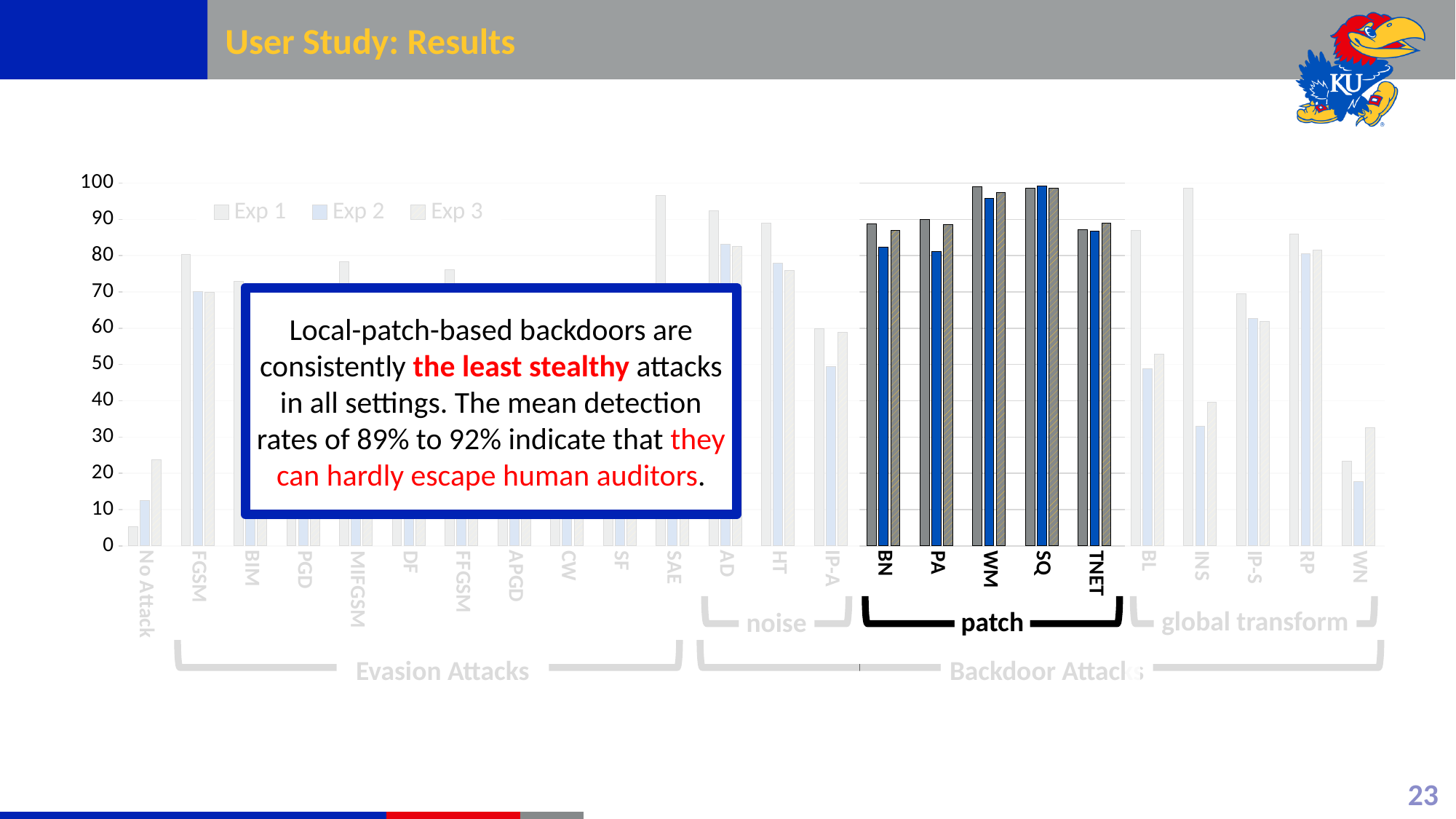
Is the Exp 1 value for No Attack greater or less than 10? less Which is larger, the Exp 1 value for WM or the Exp 2 value for BL? Exp 1 value for WM Which category has the lowest Exp 1 value in the chart? No Attack How many series does the chart legend list? 3 What group label is shown under the BN, PA, WM, SQ and TNET categories? patch Is the Exp 2 value for WN greater or less than 30? less Is the Exp 2 value for SQ greater or less than 90? greater How many attack categories are shown along the x axis of the chart? 24 What are the series names listed in the chart legend? Exp 1, Exp 2, Exp 3 What kind of chart is shown on the slide? bar chart